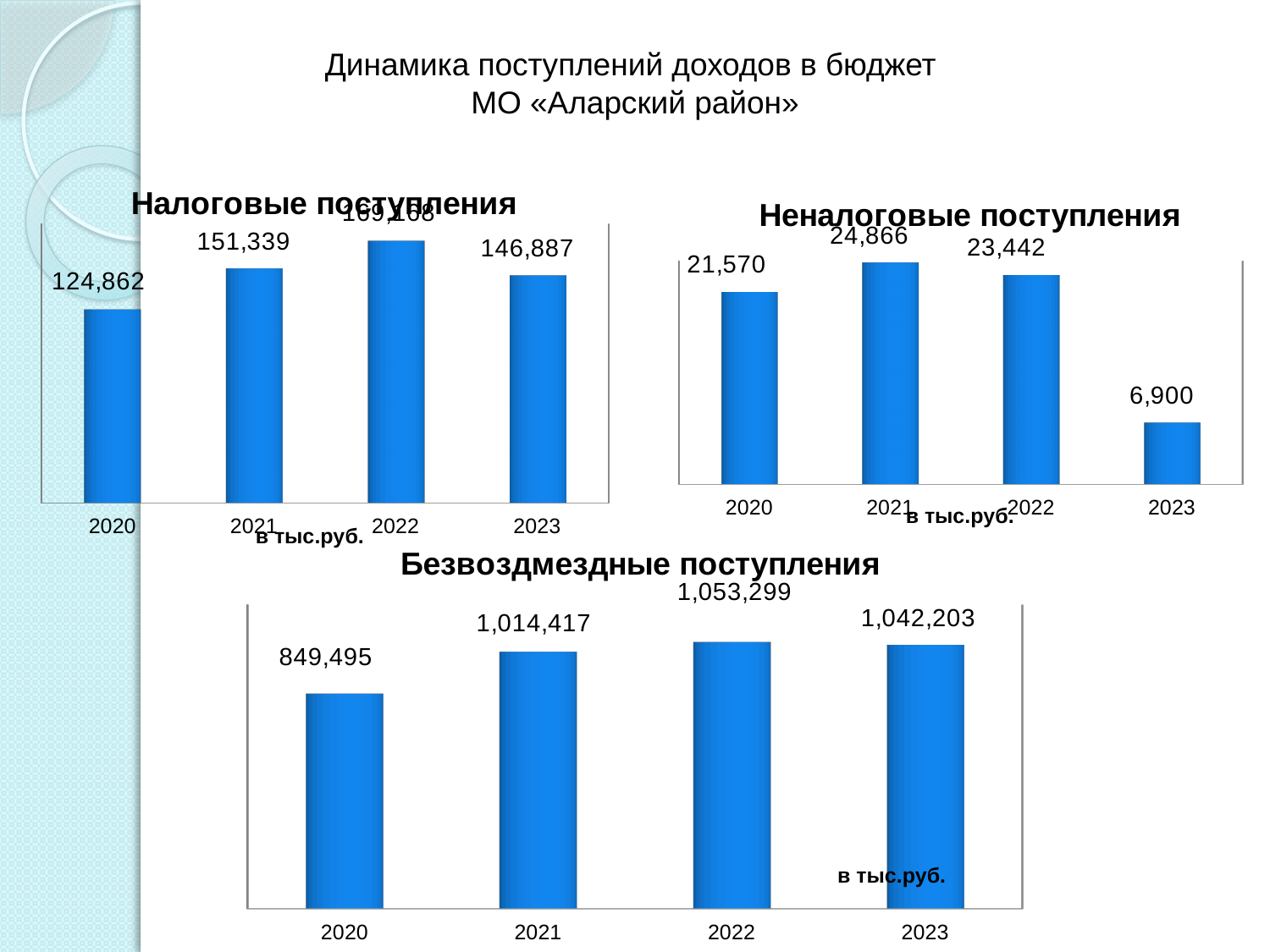
In the 'Безвозмездные поступления' chart, which year has the highest value? 2022 How many years are shown in the 'Безвозмездные поступления' chart? 4 In the 'Неналоговые поступления' chart, which is larger, the value for 2021 or the value for 2022? 2021 In the 'Неналоговые поступления' chart, which year has the lowest value? 2023 In the 'Налоговые поступления' chart, what is the value for 2020? 124,862 What type of chart is the 'Безвозмездные поступления' chart? Bar chart In the 'Неналоговые поступления' chart, what is the difference between the 2021 and 2020 values? 3,296 In the 'Налоговые поступления' chart, which year has the highest value? 2022 In the 'Неналоговые поступления' chart, what is the value for 2023? 6,900 In the 'Налоговые поступления' chart, what is the value for 2023? 146,887 In the 'Безвозмездные поступления' chart, what is the value for 2021? 1,014,417 In the 'Налоговые поступления' chart, what is the difference between the 2021 and 2020 values? 26,477